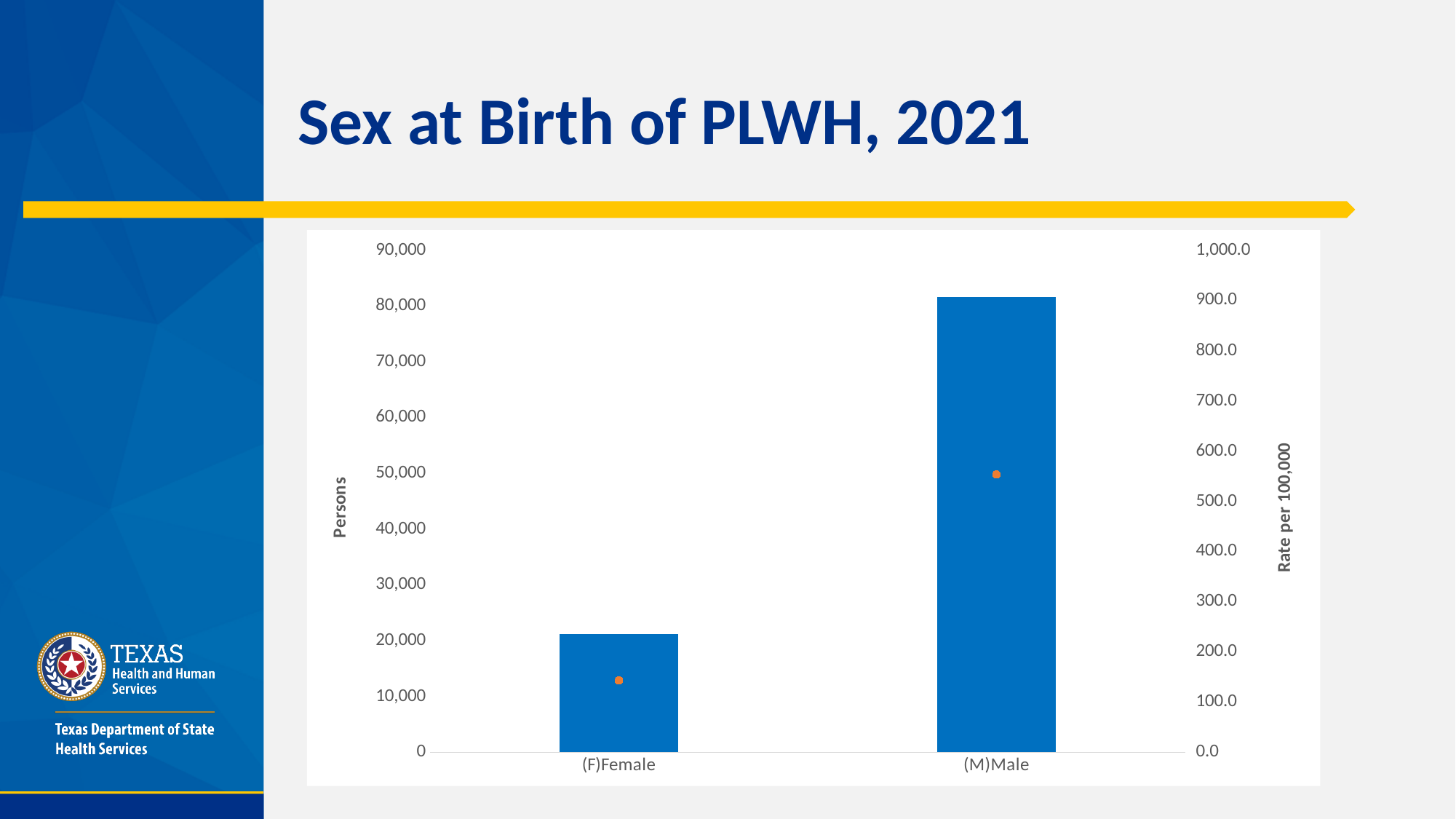
What is the title of the slide? Sex at Birth of PLWH, 2021 Which category has the highest number of persons? (M)Male Is the rate per 100,000 for (F)Female greater or less than 200.0? less What kind of chart is shown on the slide? bar chart How many categories are shown on the x axis? 2 Is the rate per 100,000 for (M)Male greater or less than 400.0? greater What is the label of the right-hand vertical axis? Rate per 100,000 Is the number of persons for (F)Female greater or less than 30,000? less Which has the higher rate per 100,000, (F)Female or (M)Male? (M)Male Which category has the lowest number of persons? (F)Female